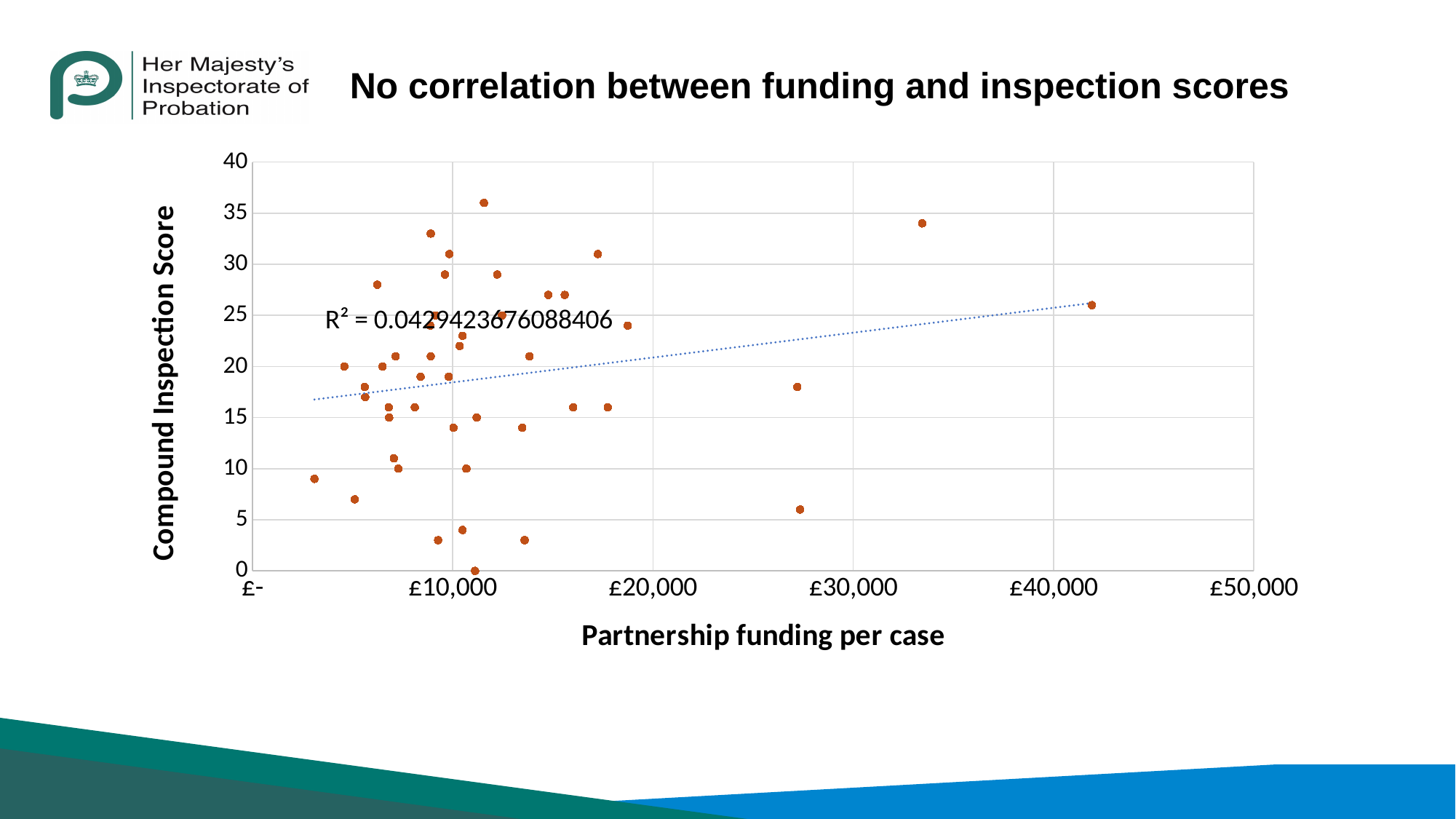
Is the point at roughly £33,000 funding per case above or below a compound inspection score of 30? above Is the partnership funding per case for the rightmost point greater or less than £40,000? greater What R² value is printed on the chart? R² = 0.0429423676088406 Does the dotted trend line rise or fall as partnership funding per case increases? Rises Is the compound inspection score of the lowest point greater or less than 5? less What is the maximum value shown on the vertical axis? 40 What is the label of the horizontal axis? Partnership funding per case What kind of chart is shown on the slide? Scatter chart What is the title of the chart? No correlation between funding and inspection scores